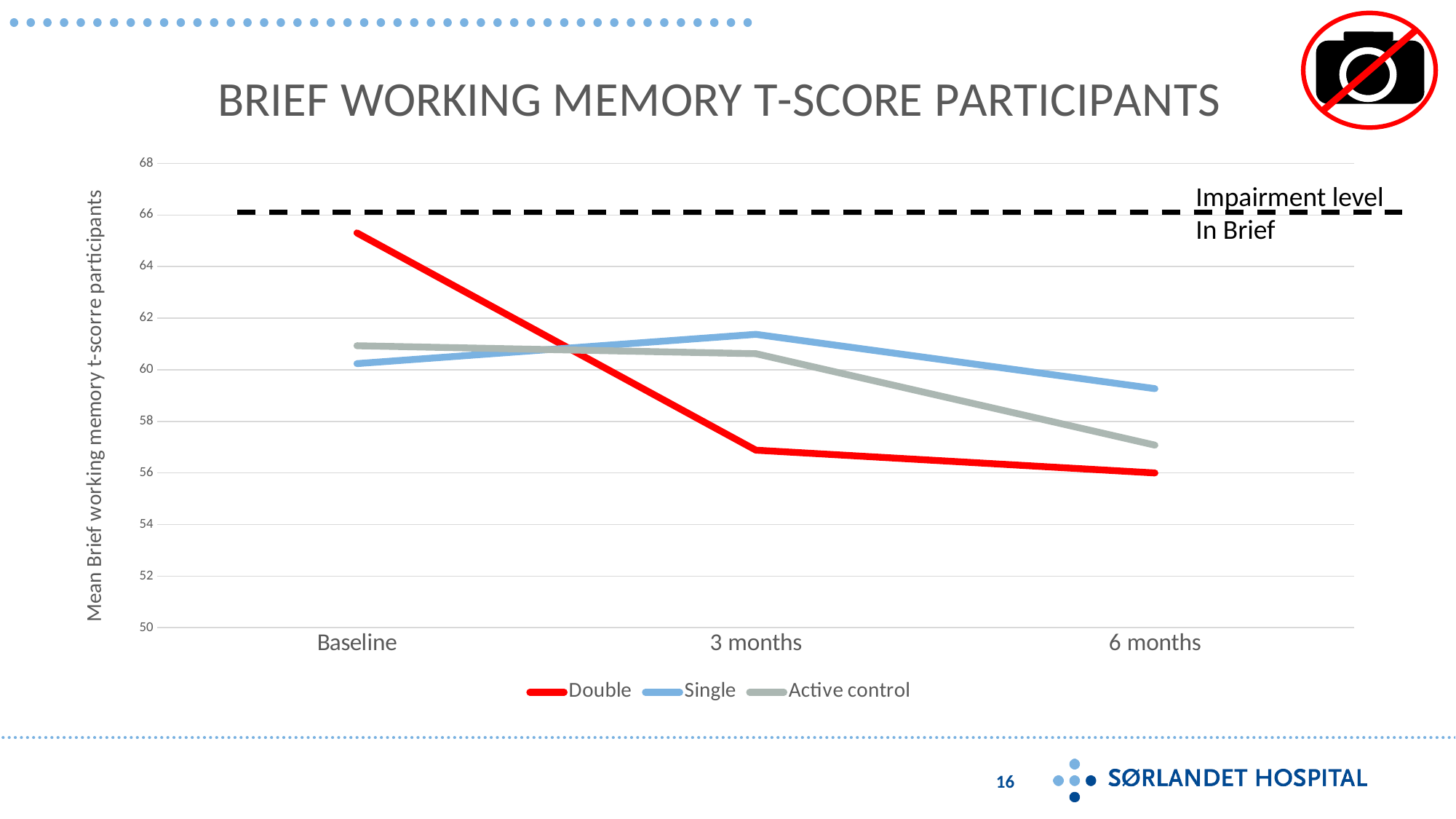
Which group has the highest value at Baseline? Double How many time points are shown on the x axis? 3 At 6 months, which is larger: the value for Single or the value for Active control? Single Does the Double line rise or fall from Baseline to 6 months? fall Is the value for Double at 6 months greater or less than 58? less Is the value for Single at 3 months greater or less than 60? greater Which group has the lowest value at 6 months? Double What kind of chart is shown on the slide? line chart What does the dashed horizontal line represent? Impairment level In Brief Which group has the highest value at 3 months? Single Is the value for Double at Baseline greater or less than 64? greater How many series does the legend list? 3